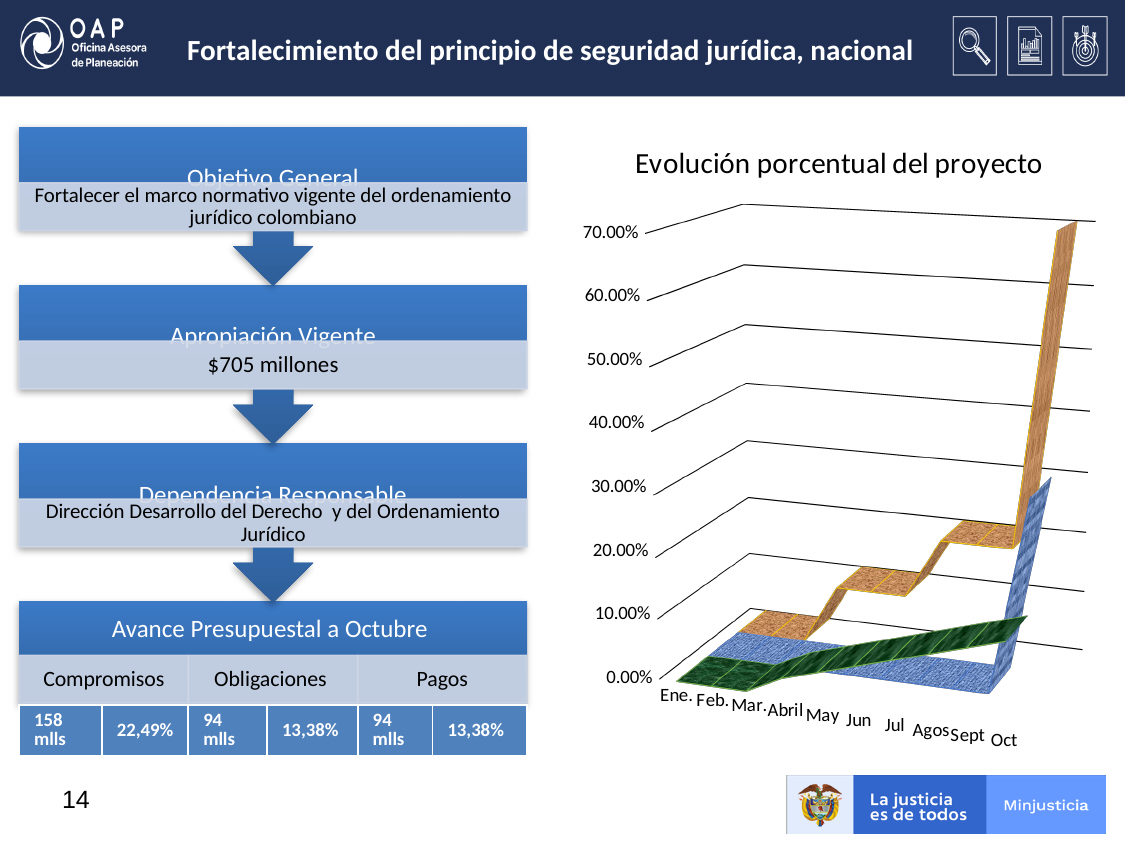
What kind of chart is shown under the title "Evolución porcentual del proyecto"? 3D line chart In the "Evolución porcentual del proyecto" chart, is the value of the orange series at Ene. greater or less than 30.00%? less What is the last category on the x axis of the "Evolución porcentual del proyecto" chart? Oct How many months are shown on the x axis of the "Evolución porcentual del proyecto" chart? 10 In the "Evolución porcentual del proyecto" chart, do the values of the orange series rise or fall from Ene. to Oct? rise In the "Evolución porcentual del proyecto" chart, which month has the highest value for the orange series? Oct In the "Evolución porcentual del proyecto" chart, is the value of the green series at Oct greater or less than 30.00%? less In the "Evolución porcentual del proyecto" chart, is the orange series value larger at Oct or at Jun? Oct What is the title of the chart on the right side of the slide? Evolución porcentual del proyecto In the "Evolución porcentual del proyecto" chart, is the value of the orange series at Oct greater or less than 40.00%? greater What is the first category on the x axis of the "Evolución porcentual del proyecto" chart? Ene.